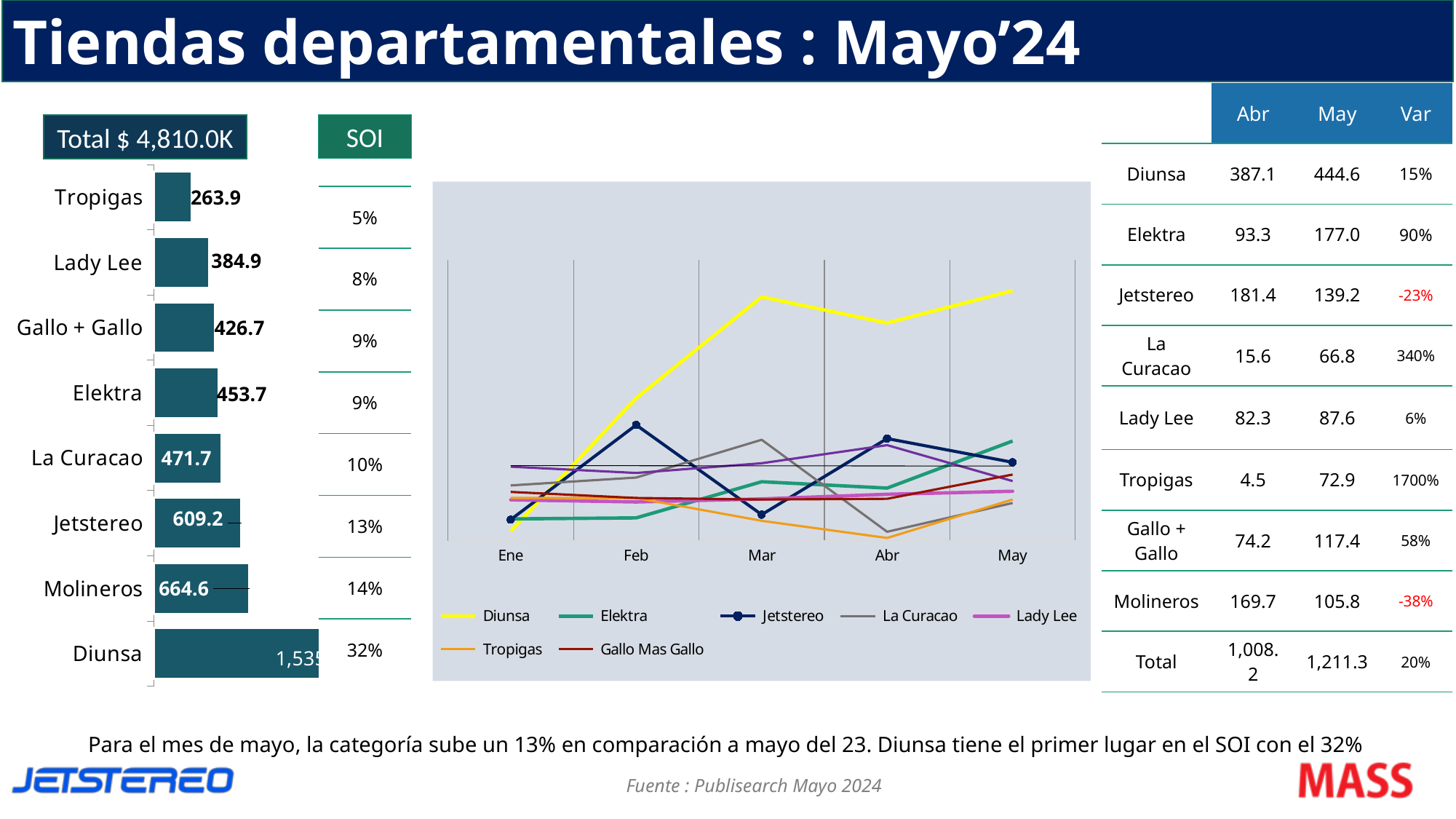
In the bar chart on the left, which category has the lowest value? Tropigas How many categories are shown in the bar chart on the left? 8 What kind of chart is the chart on the left of the slide? Bar chart In the line chart in the middle, which series has the highest value in May? Diunsa In the bar chart on the left, which category has the highest value? Diunsa In the bar chart on the left, what is the value for Jetstereo? 609.2 In the bar chart on the left, which is larger, the value for Elektra or the value for Gallo + Gallo? Elektra What total is shown in the box above the bar chart on the left? Total $ 4,810.0K How many months are shown on the x axis of the line chart in the middle? 5 How many series does the legend of the line chart in the middle list? 7 In the bar chart on the left, what is the value for Tropigas? 263.9 In the bar chart on the left, what is the difference between the values for Molineros and Jetstereo? 55.4